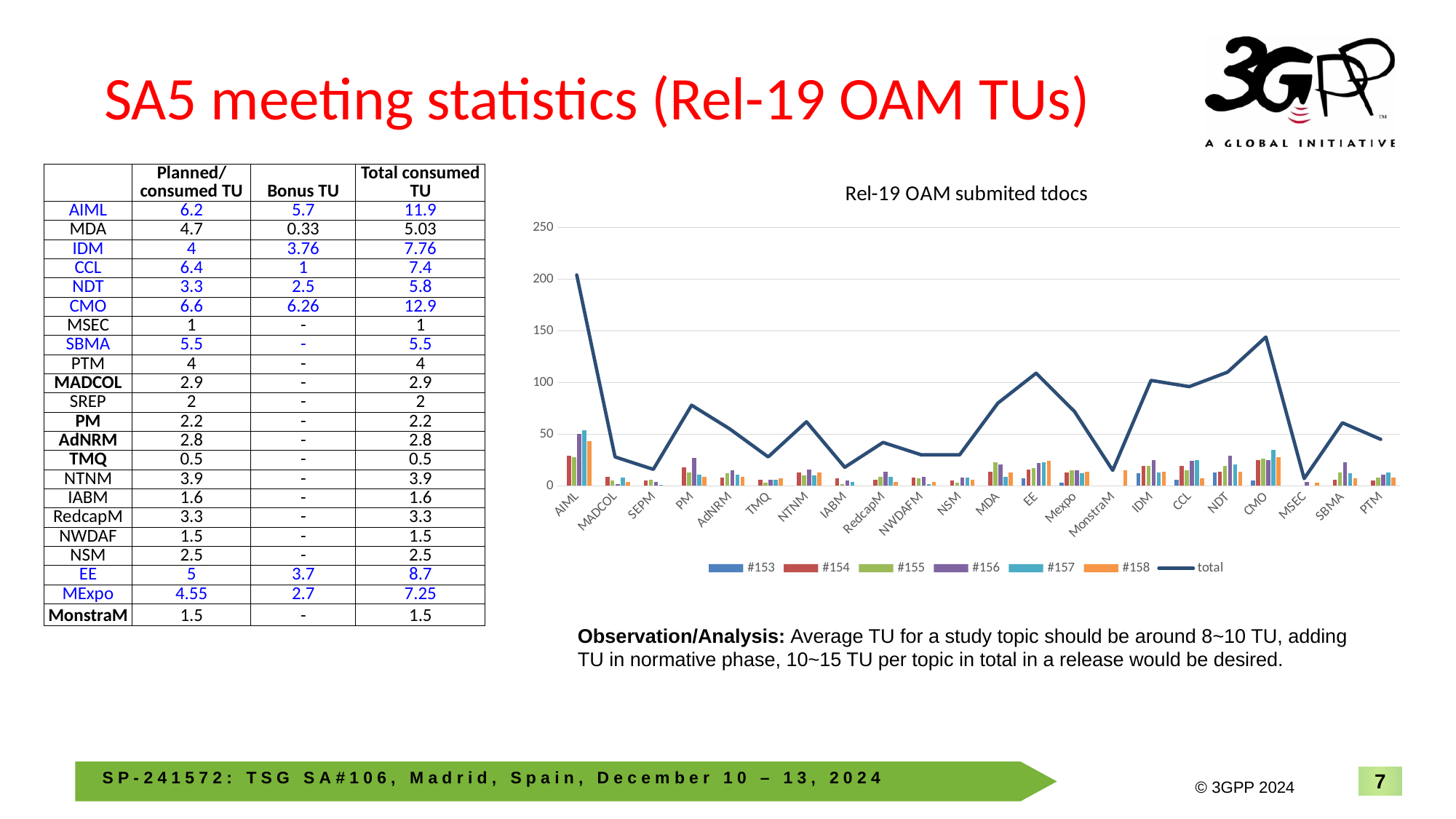
Which category has the highest value on the 'total' line? AIML What is the title of the chart on the slide? Rel-19 OAM submited tdocs Which has the larger 'total' value, CMO or MDA? CMO How many categories are shown along the x axis of the chart? 22 Does the 'total' line rise or fall from MonstraM to CMO? rise Is the 'total' value for AIML greater or less than 150? greater Which category has the lowest value on the 'total' line? MSEC Is the 'total' value for CMO greater or less than 100? greater Is the 'total' value for MADCOL greater or less than 50? less How many series does the chart legend list? 7 Which has the larger 'total' value, AIML or CMO? AIML What kind of chart is shown on the slide? Combined bar and line chart